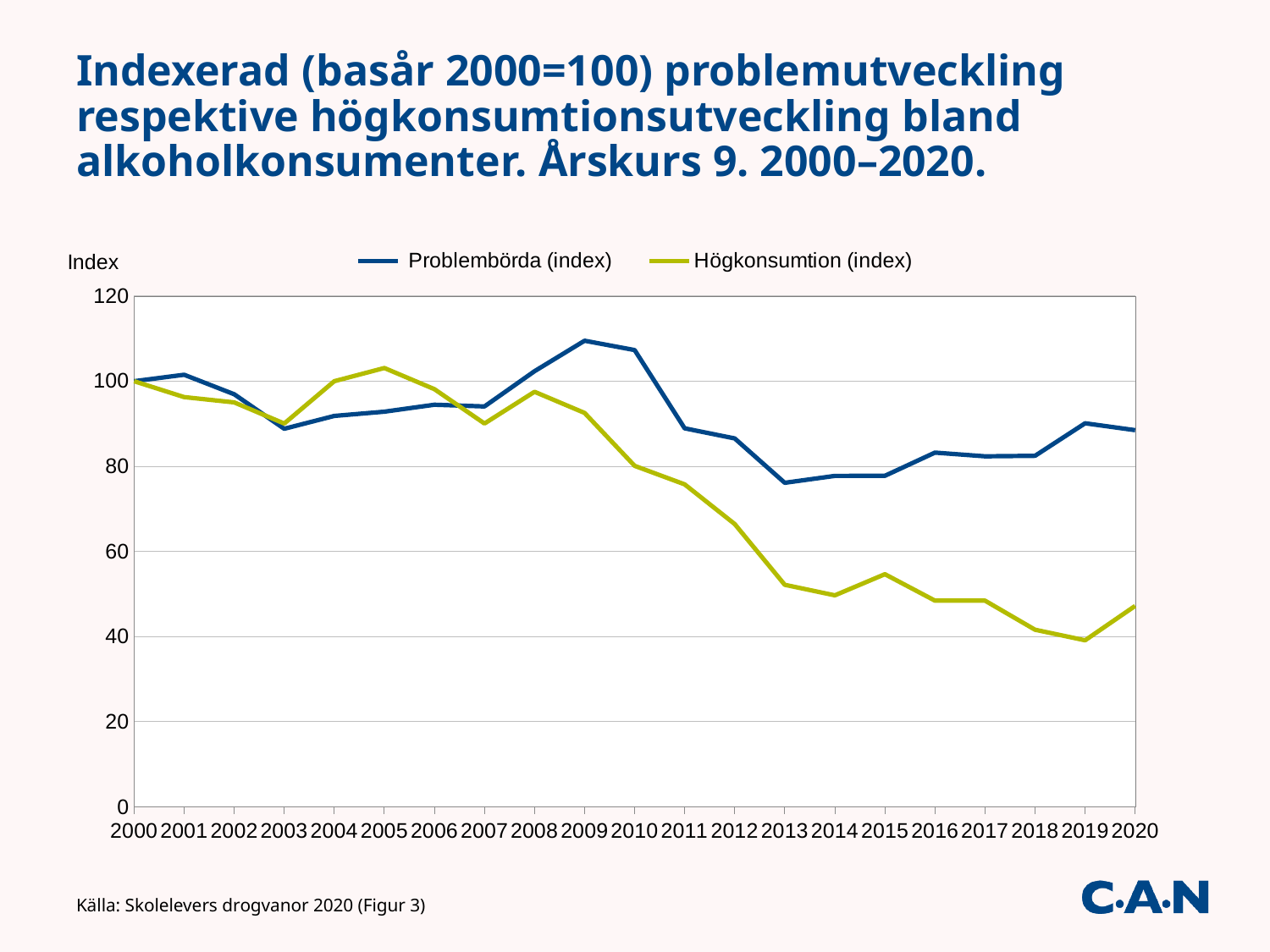
What is the value of Högkonsumtion (index) in 2000? 100 Is the value for Högkonsumtion (index) in 2013 greater or less than 60? less Is the value for Problembörda (index) in 2009 greater or less than 100? greater In which year does Högkonsumtion (index) reach its lowest value? 2019 What is the value of Problembörda (index) in 2000? 100 In which year does Problembörda (index) reach its highest value? 2009 Does Högkonsumtion (index) overall rise or fall from 2000 to 2020? fall Which series has the larger value in 2020, Problembörda (index) or Högkonsumtion (index)? Problembörda (index) How many series does the legend list? 2 What kind of chart is shown on the slide? line chart In which year does Högkonsumtion (index) reach its highest value? 2005 How many years are plotted along the x axis? 21